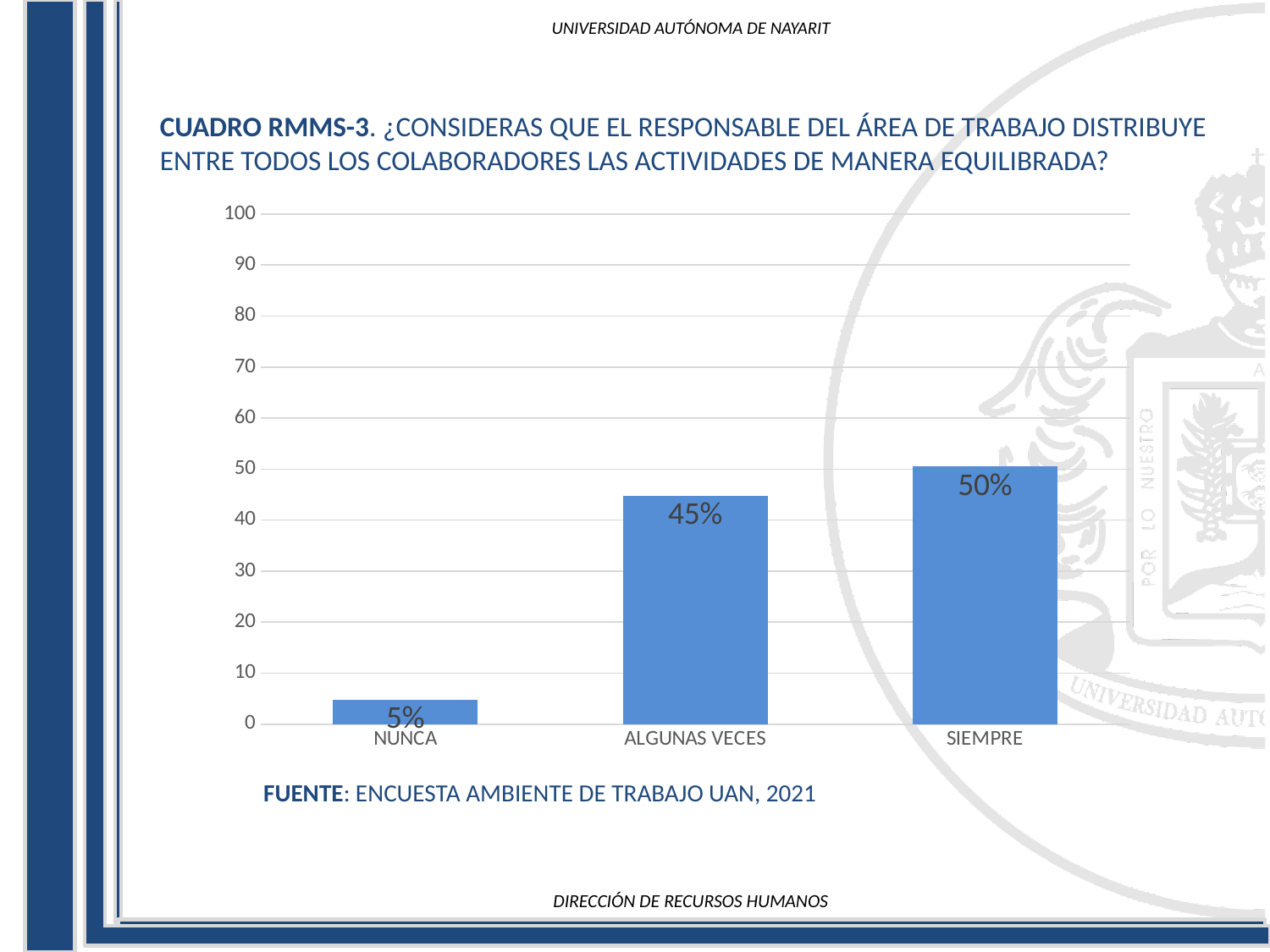
What is the difference between the values for SIEMPRE and ALGUNAS VECES? 5% What is the difference between the values for ALGUNAS VECES and NUNCA? 40% Which is larger, the value for NUNCA or the value for ALGUNAS VECES? ALGUNAS VECES Which category has the lowest value? NUNCA Which category has the highest value? SIEMPRE What is the value for SIEMPRE? 50% Do the values rise or fall from NUNCA to SIEMPRE along the x axis? rise What kind of chart is shown on the slide? bar chart How many categories are shown on the x axis? 3 What is the value for NUNCA? 5% What is the value for ALGUNAS VECES? 45% Is the value for ALGUNAS VECES greater or less than 40? greater